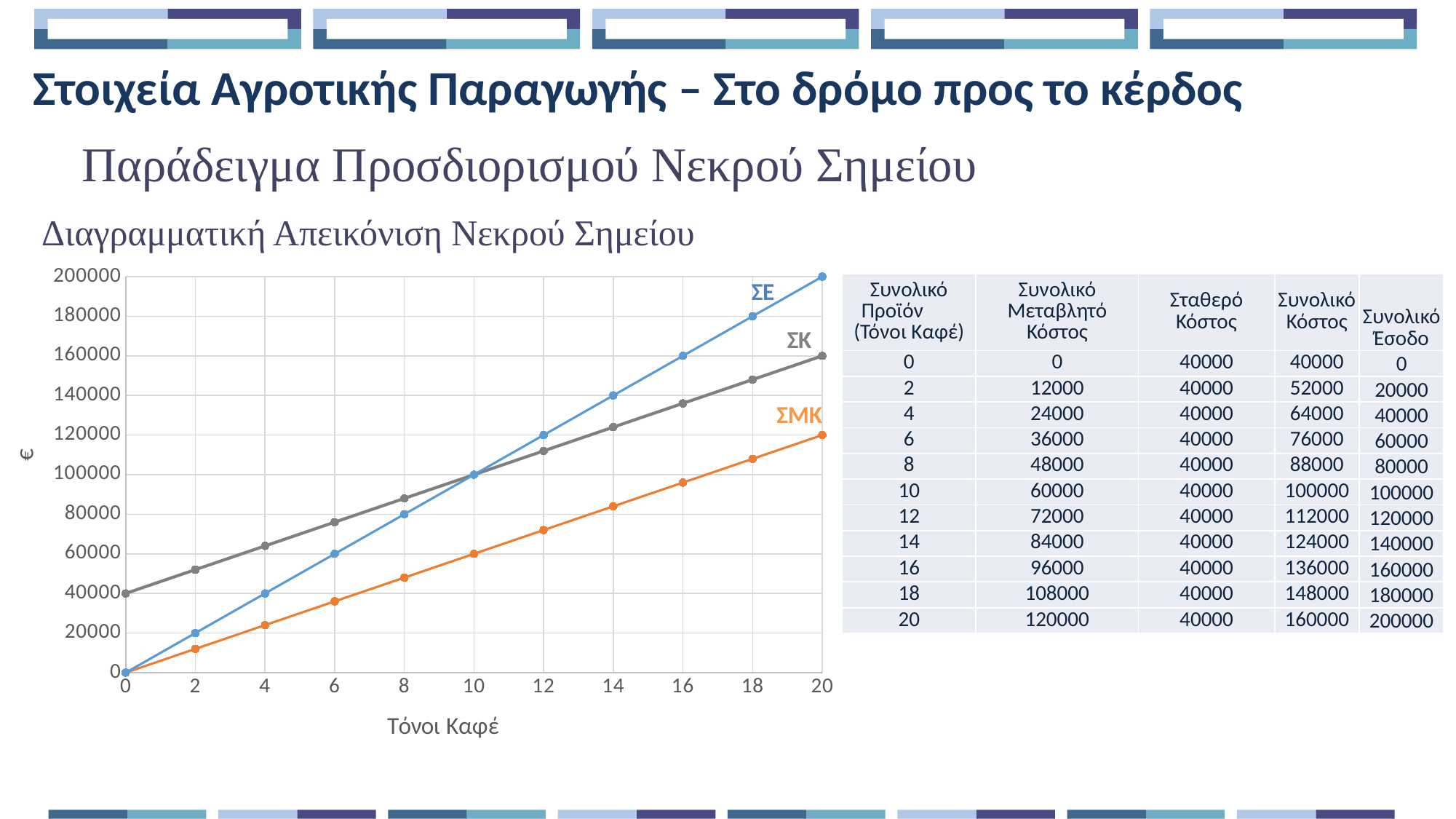
What is the difference between ΣΚ and ΣΜΚ at 10 tons of coffee? 40000 Is the value of ΣΜΚ at 14 tons of coffee greater or less than 100000? less What is the title of the x axis of the chart? Τόνοι Καφέ Which series has the highest value at 20 tons of coffee? ΣΕ What is the value of ΣΕ at 20 tons of coffee? 200000 How many series are plotted in the chart? 3 What is the value of ΣΚ at 0 tons of coffee? 40000 Does the ΣΕ line rise or fall as tons of coffee increase? rises What is the value of ΣΜΚ at 20 tons of coffee? 120000 At 4 tons of coffee, which is larger, ΣΚ or ΣΕ? ΣΚ What kind of chart is shown on the slide? line chart At 16 tons of coffee, which is larger, ΣΕ or ΣΚ? ΣΕ